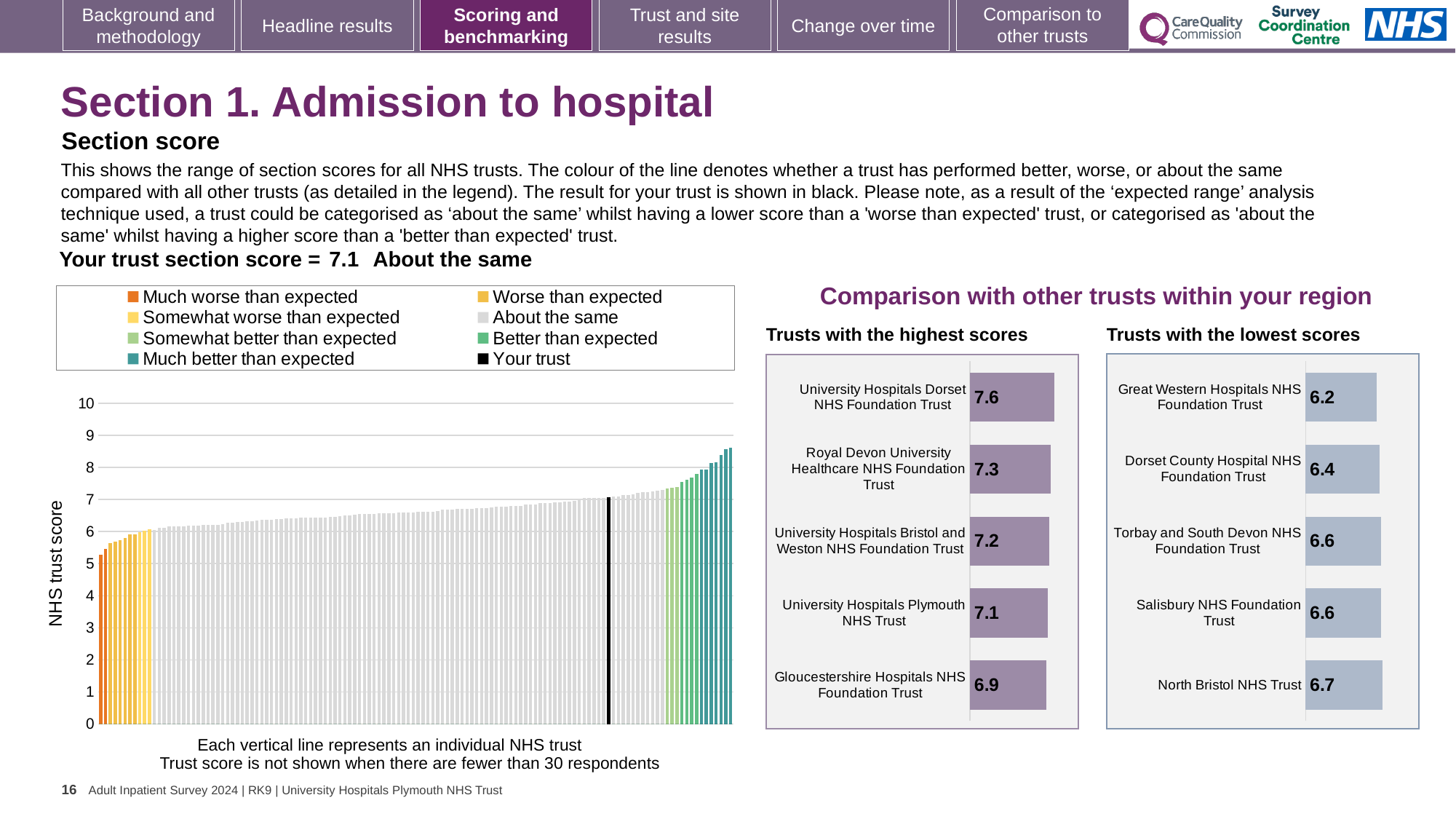
In the large chart on the left showing the range of section scores, what is the score for your trust (the black line)? 7.1 In the 'Trusts with the lowest scores' chart, which trust has the highest score shown? North Bristol NHS Trust In the 'Trusts with the lowest scores' chart, what is the score for Great Western Hospitals NHS Foundation Trust? 6.2 How many trusts are shown in the 'Trusts with the lowest scores' chart? 5 In the 'Trusts with the highest scores' chart, what is the score for University Hospitals Dorset NHS Foundation Trust? 7.6 How many entries does the legend of the large chart on the left list? 8 In the large chart on the left, is the value of the leftmost (orange) bar greater or less than 6? less In the 'Trusts with the highest scores' chart, what is the difference between the scores of University Hospitals Dorset NHS Foundation Trust and Gloucestershire Hospitals NHS Foundation Trust? 0.7 In the 'Trusts with the lowest scores' chart, which has the larger score: Dorset County Hospital NHS Foundation Trust or North Bristol NHS Trust? North Bristol NHS Trust In the large chart on the left, is the value of the rightmost bar greater or less than 8? greater In the large chart on the left, do the trust scores rise or fall from left to right? rise In the 'Trusts with the highest scores' chart, which trust has the lowest score shown? Gloucestershire Hospitals NHS Foundation Trust